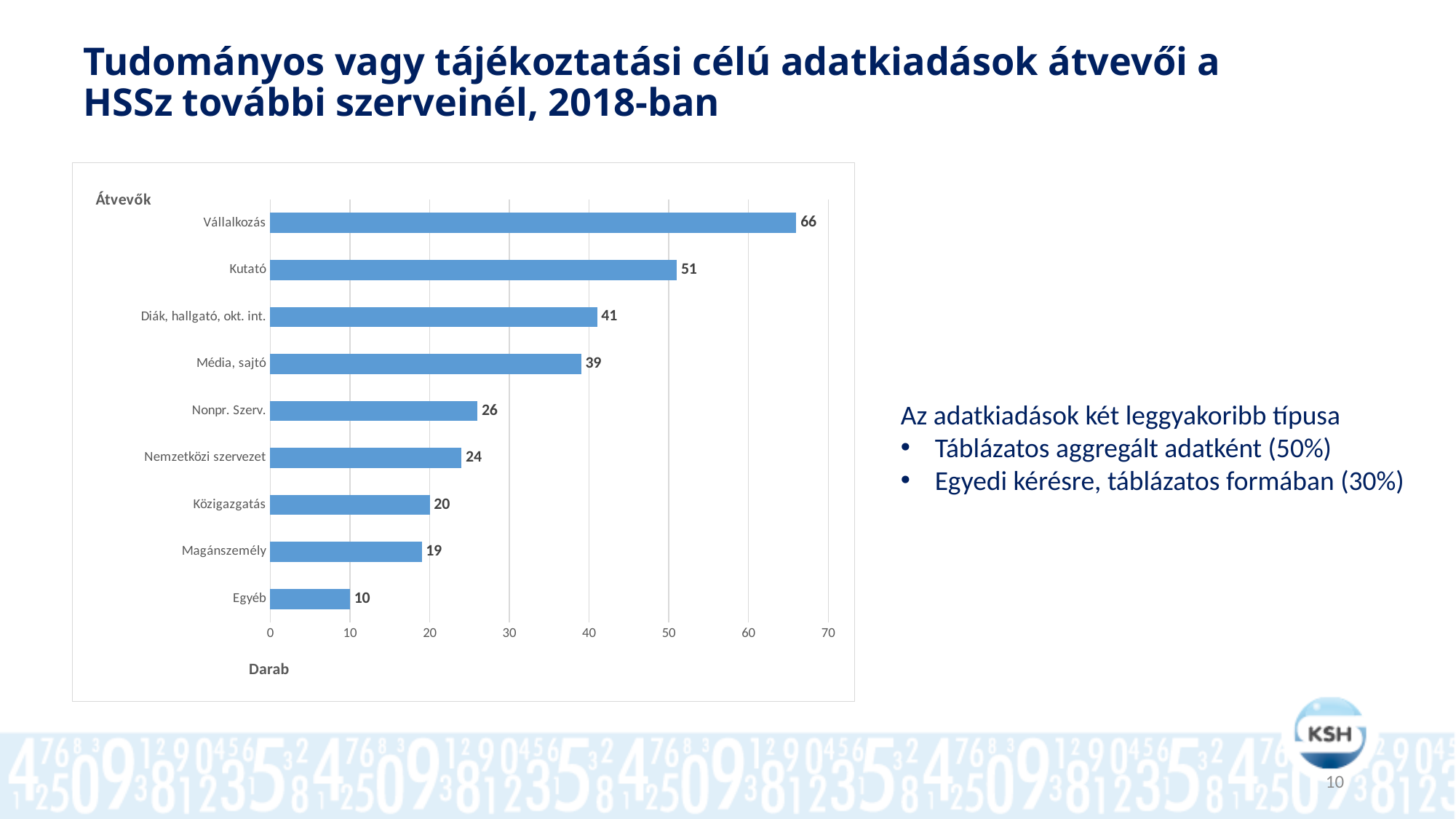
What kind of chart is shown on the slide? bar chart How many categories are shown in the chart? 9 What is the difference between the values for Nonpr. Szerv. and Nemzetközi szervezet? 2 What is the value for Magánszemély? 19 Which category has the lowest value? Egyéb What is the difference between the values for Vállalkozás and Kutató? 15 What is the label of the horizontal axis? Darab Is the value for Kutató greater or less than 40? greater What is the value for Média, sajtó? 39 What is the value for Vállalkozás? 66 Which category has the highest value? Vállalkozás Which is larger, the value for Diák, hallgató, okt. int. or the value for Közigazgatás? Diák, hallgató, okt. int.